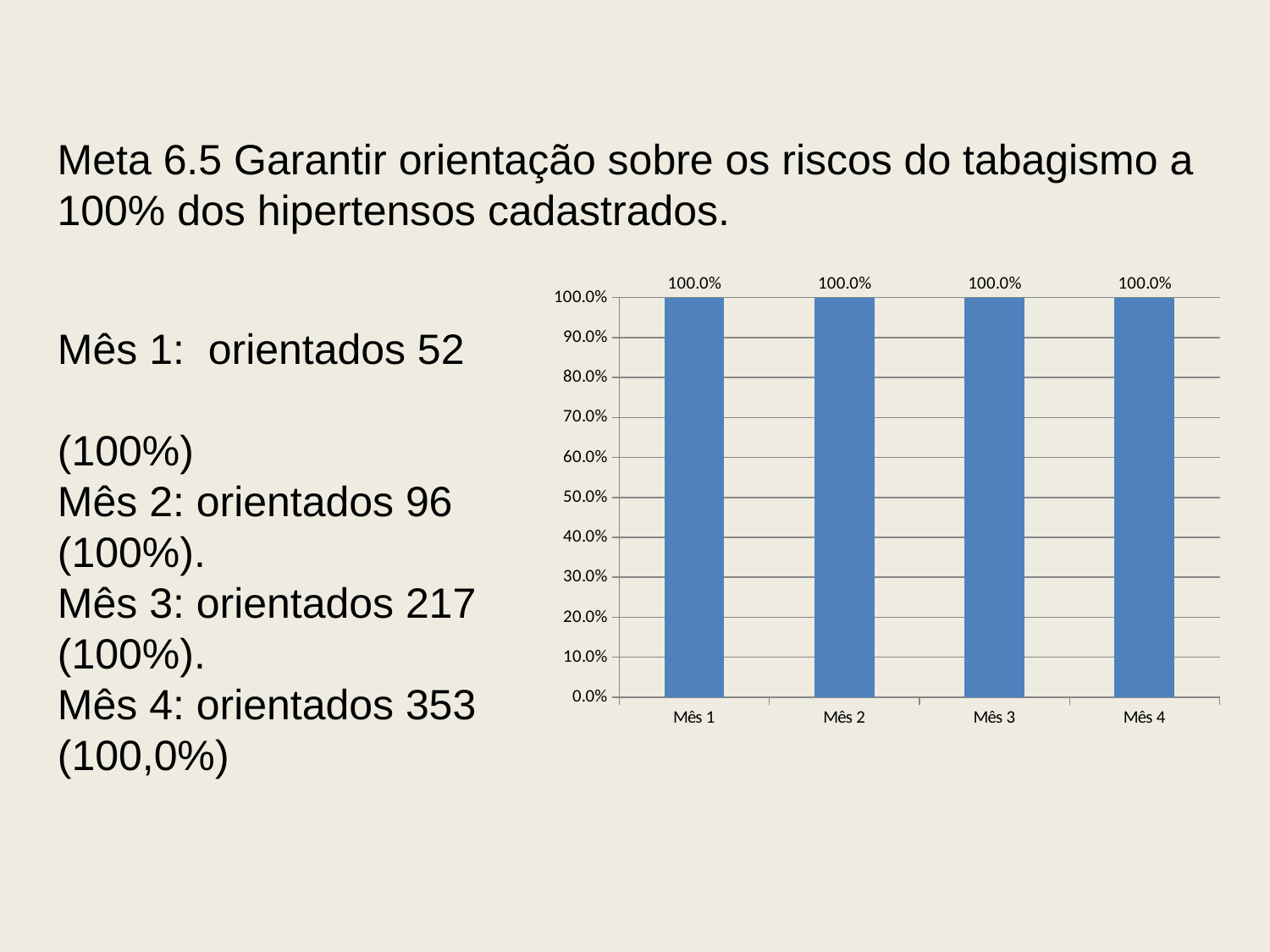
What is the value for Mês 1 in the bar chart? 100.0% What is the difference between the values for Mês 4 and Mês 1? 0.0% What is the value for Mês 4 in the bar chart? 100.0% What is the value for Mês 3 in the bar chart? 100.0% What kind of chart is shown on the slide? Bar chart What is the value for Mês 2 in the bar chart? 100.0% Do the values rise, fall, or stay the same from Mês 1 to Mês 4? Stay the same Is the value for Mês 3 greater or less than 90.0%? greater What colour are the bars in the chart? Blue How many categories are shown on the x axis of the chart? 4 What is the highest tick value shown on the y axis of the chart? 100.0%